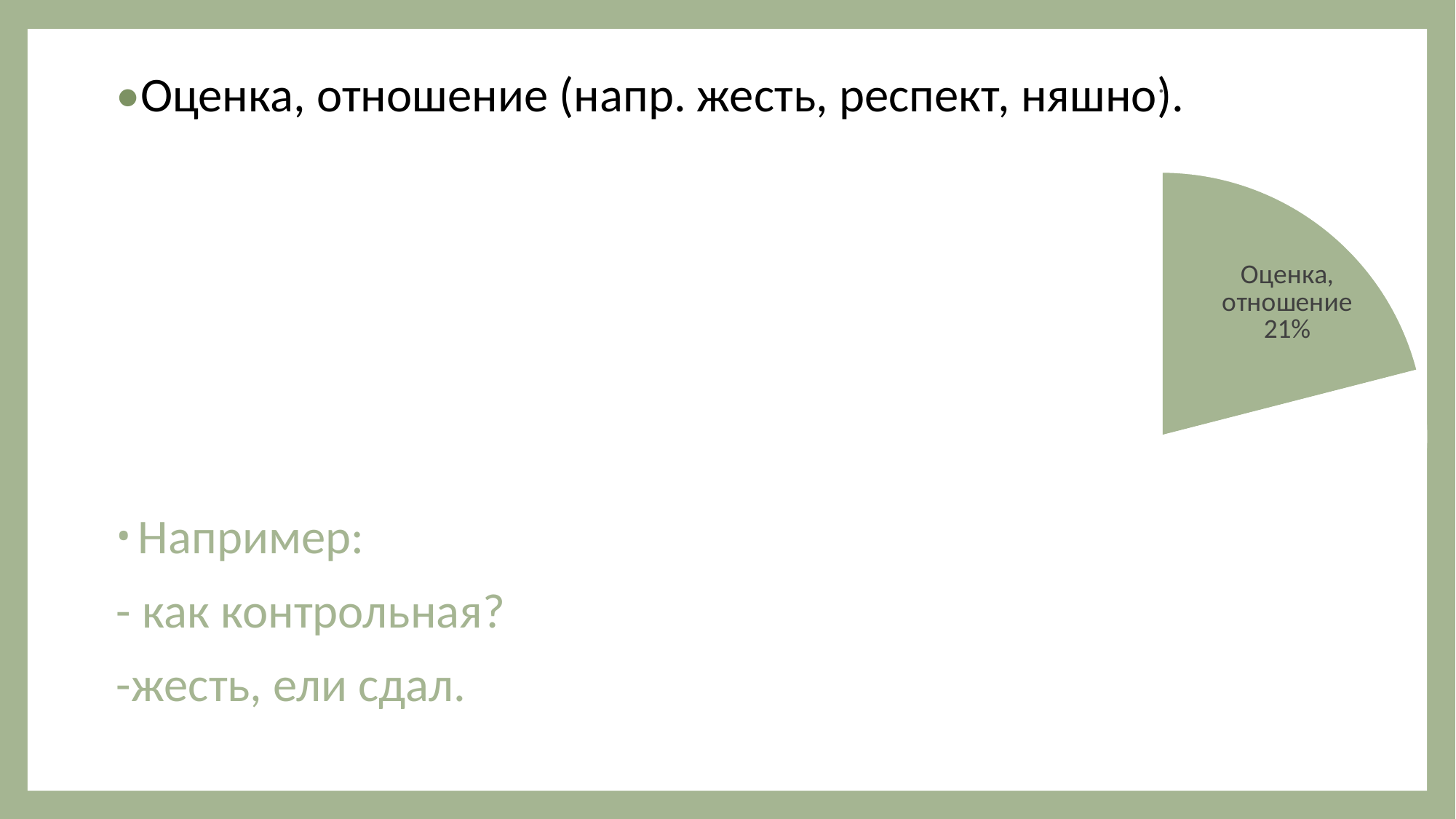
What is the label of the visible slice in the pie chart? Оценка, отношение What percentage is printed inside the visible slice of the pie chart? 21% Is the share of the "Оценка, отношение" slice greater or less than 50%? less What share of the pie does the slice labelled "Оценка, отношение" represent? 21% What kind of chart is shown on the right side of the slide? pie chart